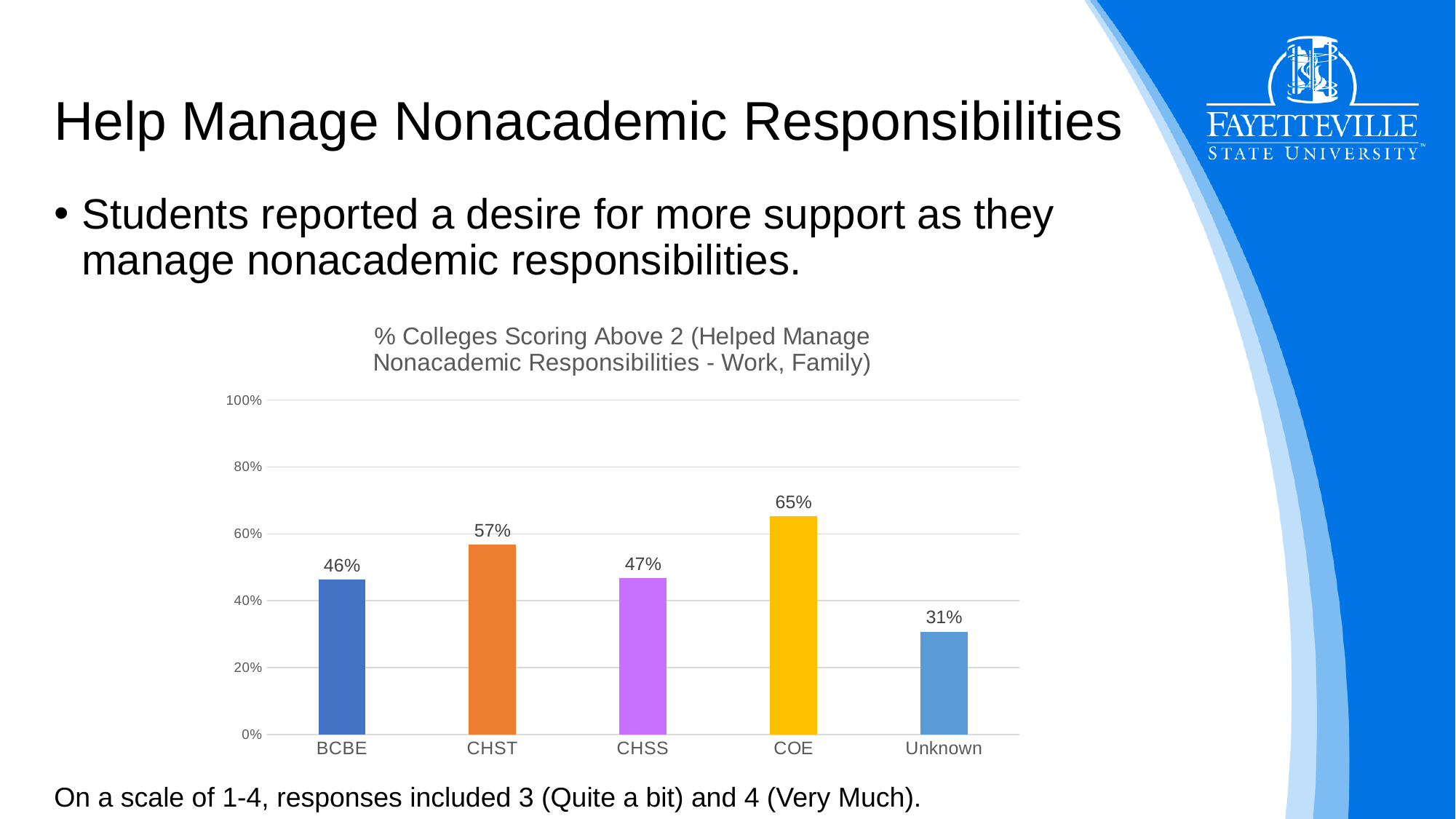
What kind of chart is shown on the slide? Bar chart What is the value for Unknown? 31% What is the value for COE? 65% How many categories are shown on the x axis? 5 What is the title of the chart? % Colleges Scoring Above 2 (Helped Manage Nonacademic Responsibilities - Work, Family) Is the value for CHSS greater or less than 40%? greater What is the difference between the values for CHSS and Unknown? 16% What is the difference between the values for COE and CHST? 8% What is the value for BCBE? 46% Which is larger, the value for CHST or the value for BCBE? CHST Which category has the lowest value? Unknown Which category has the highest value? COE